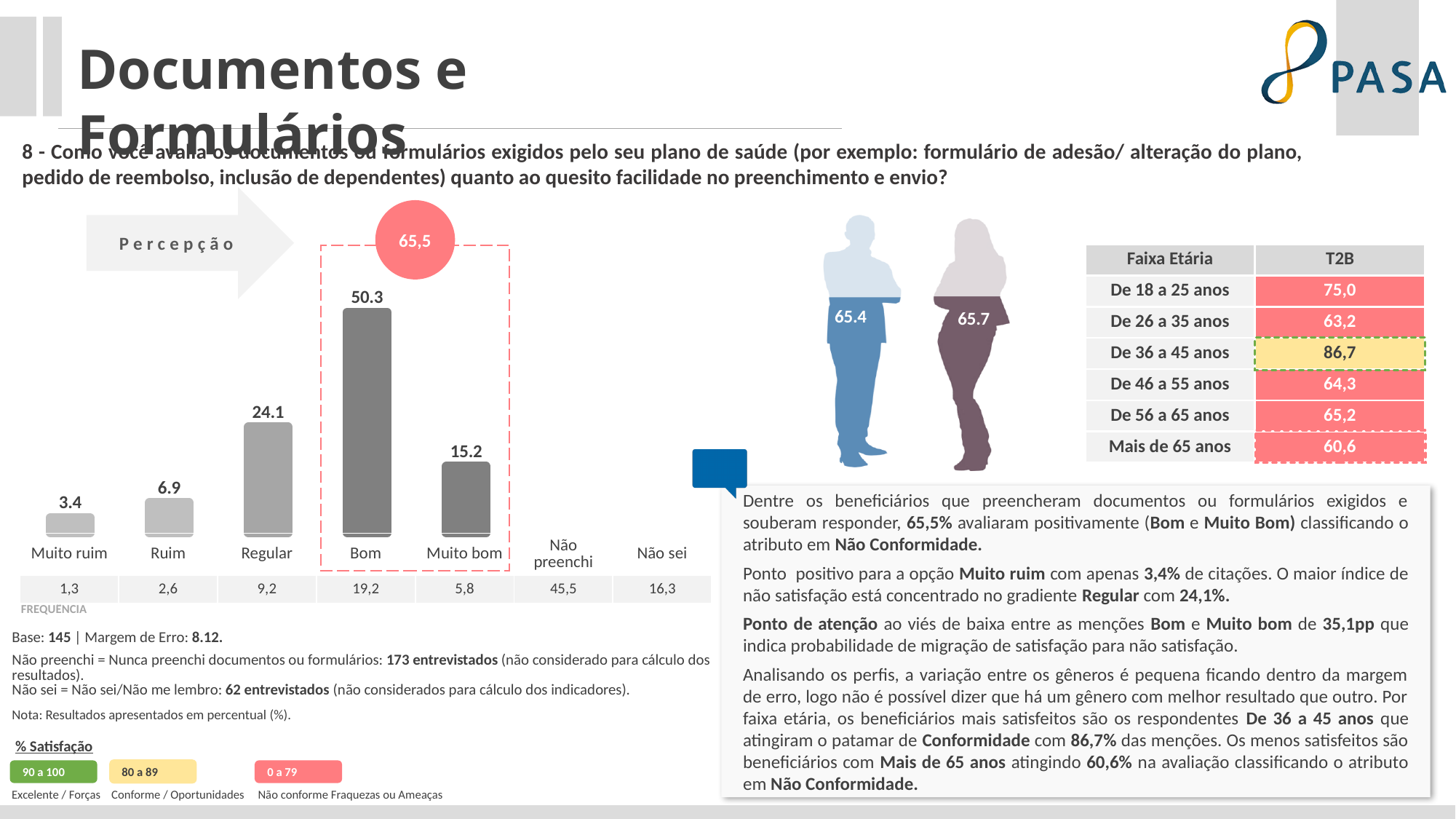
What is the value for Bom in the bar chart? 50.3 What kind of chart is shown on the left of the slide? Bar chart Which is larger in the bar chart, Regular or Muito bom? Regular How many bars are plotted in the bar chart? 5 What is the value for Ruim in the bar chart? 6.9 What is the value for Muito ruim in the bar chart? 3.4 Which category has the lowest bar in the chart? Muito ruim What is the value shown in the red circle above the Bom and Muito bom bars? 65,5 What is the difference between the values for Bom and Muito bom in the bar chart? 35.1 Which category has the highest bar in the chart? Bom What is the sum of the values for Bom and Muito bom in the bar chart? 65.5 What is the value for Regular in the bar chart? 24.1